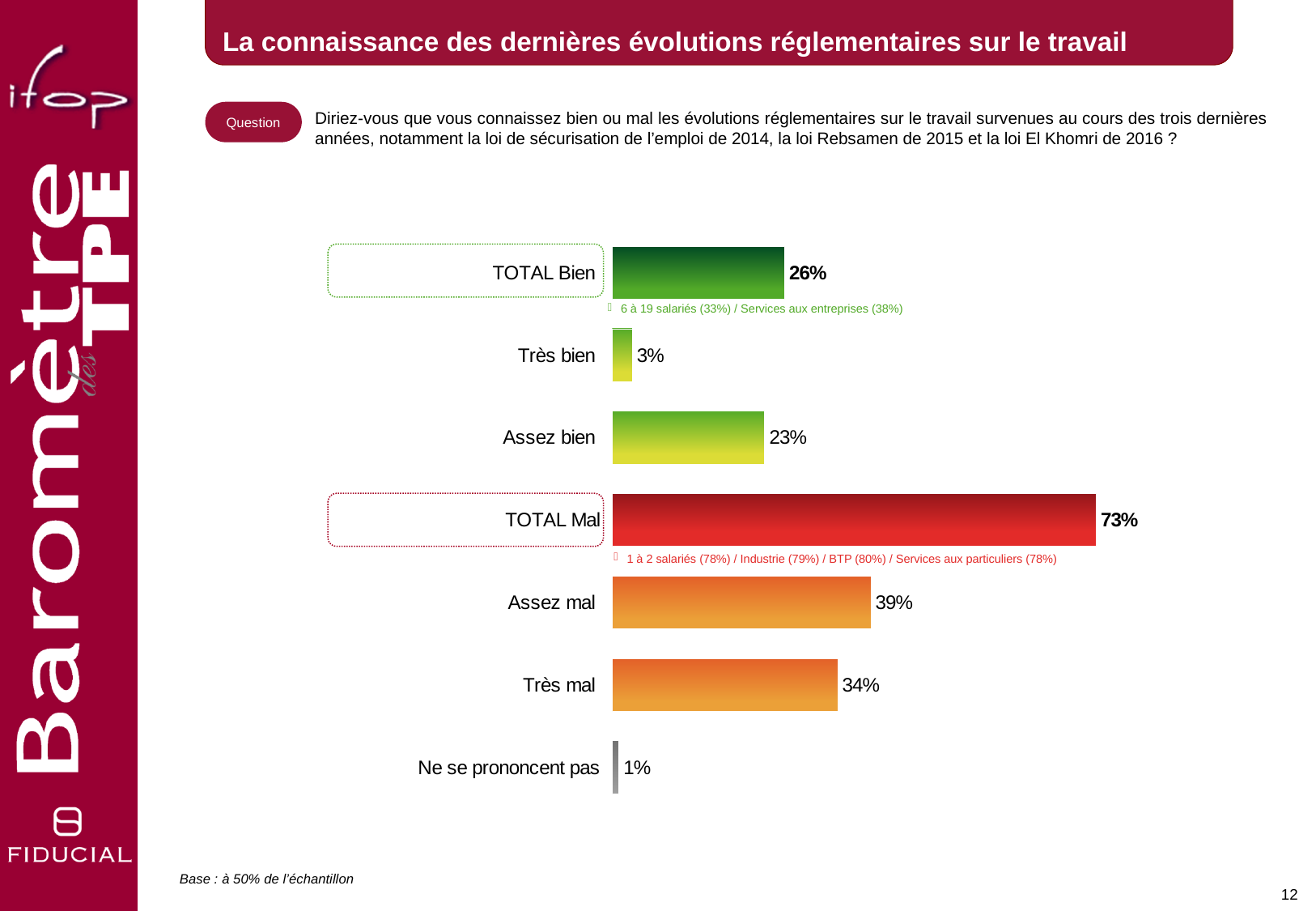
What is the value for Très bien? 3% What kind of chart is shown on the slide? Bar chart How many categories are shown in the chart? 7 What is the value for TOTAL Bien? 26% What is the value for Assez bien? 23% Which category has the highest value? TOTAL Mal Which category has the lowest value? Ne se prononcent pas What is the value for Assez mal? 39% What is the difference between TOTAL Mal and TOTAL Bien? 47 percentage points What is the value for Ne se prononcent pas? 1% Which is larger, Assez mal or Très mal? Assez mal What is the value for TOTAL Mal? 73%